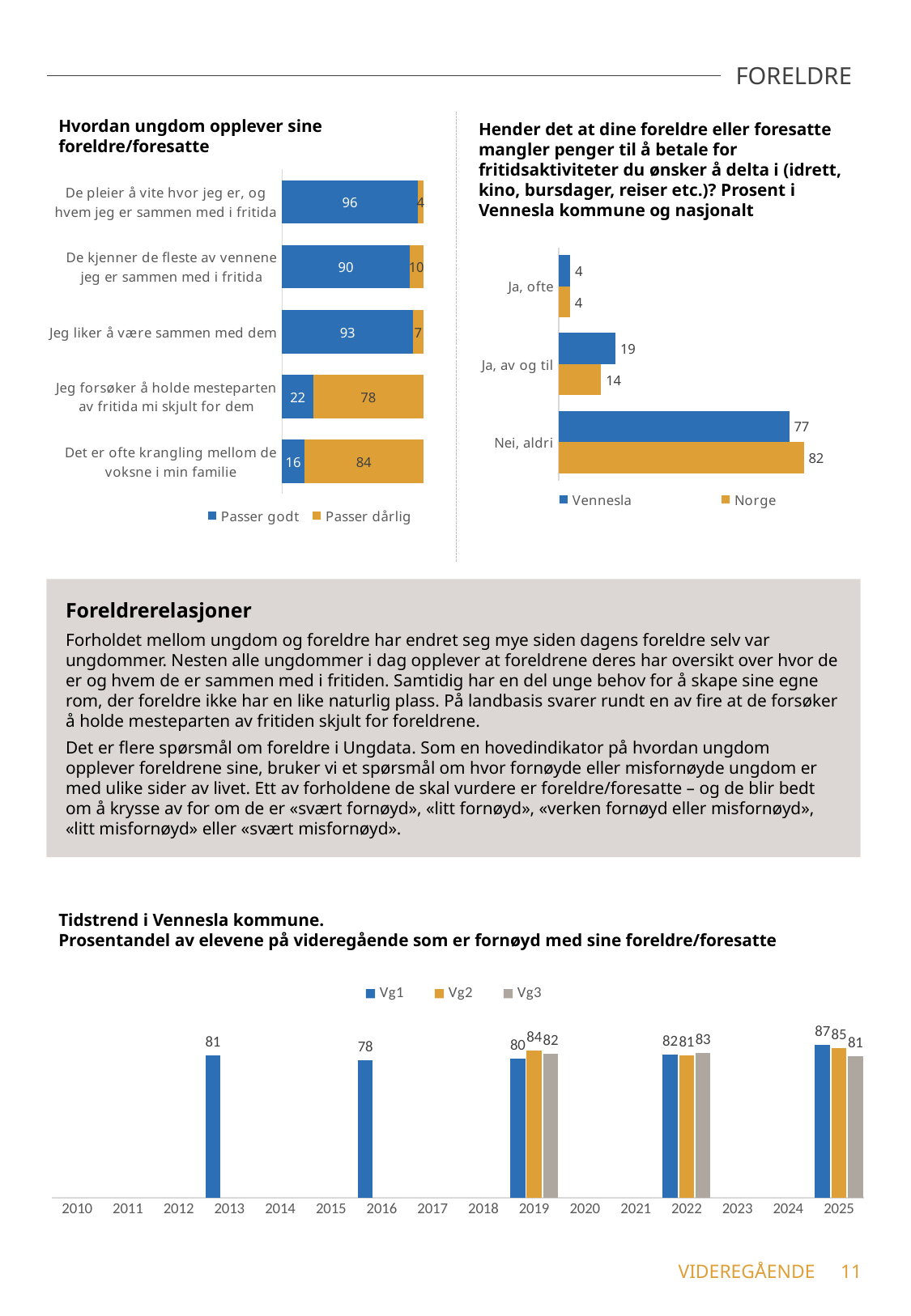
In the top-left chart 'Hvordan ungdom opplever sine foreldre/foresatte', which statement has the lowest 'Passer godt' value? Det er ofte krangling mellom de voksne i min familie In the bottom chart 'Tidstrend i Vennesla kommune', what is the Vg1 value for 2025? 87 In the top-right chart about parents lacking money for leisure activities, which is larger for 'Nei, aldri': Vennesla or Norge? Norge In the top-right chart about parents lacking money for leisure activities, what is the difference between Vennesla and Norge for 'Ja, av og til'? 5 In the bottom chart 'Tidstrend i Vennesla kommune', which series has the highest value in 2019? Vg2 In the top-right chart about parents lacking money for leisure activities, how many series does the legend list? 2 What kind of chart is the bottom chart 'Tidstrend i Vennesla kommune'? Bar chart In the top-right chart about parents lacking money for leisure activities, what is the value for Norge for 'Nei, aldri'? 82 In the top-left chart 'Hvordan ungdom opplever sine foreldre/foresatte', what is the 'Passer dårlig' value for 'Det er ofte krangling mellom de voksne i min familie'? 84 In the top-left chart 'Hvordan ungdom opplever sine foreldre/foresatte', how many statements are shown? 5 In the top-left chart 'Hvordan ungdom opplever sine foreldre/foresatte', what is the 'Passer godt' value for 'De pleier å vite hvor jeg er, og hvem jeg er sammen med i fritida'? 96 In the top-left chart 'Hvordan ungdom opplever sine foreldre/foresatte', what is the total of the stacked bar for 'Jeg forsøker å holde mesteparten av fritida mi skjult for dem'? 100